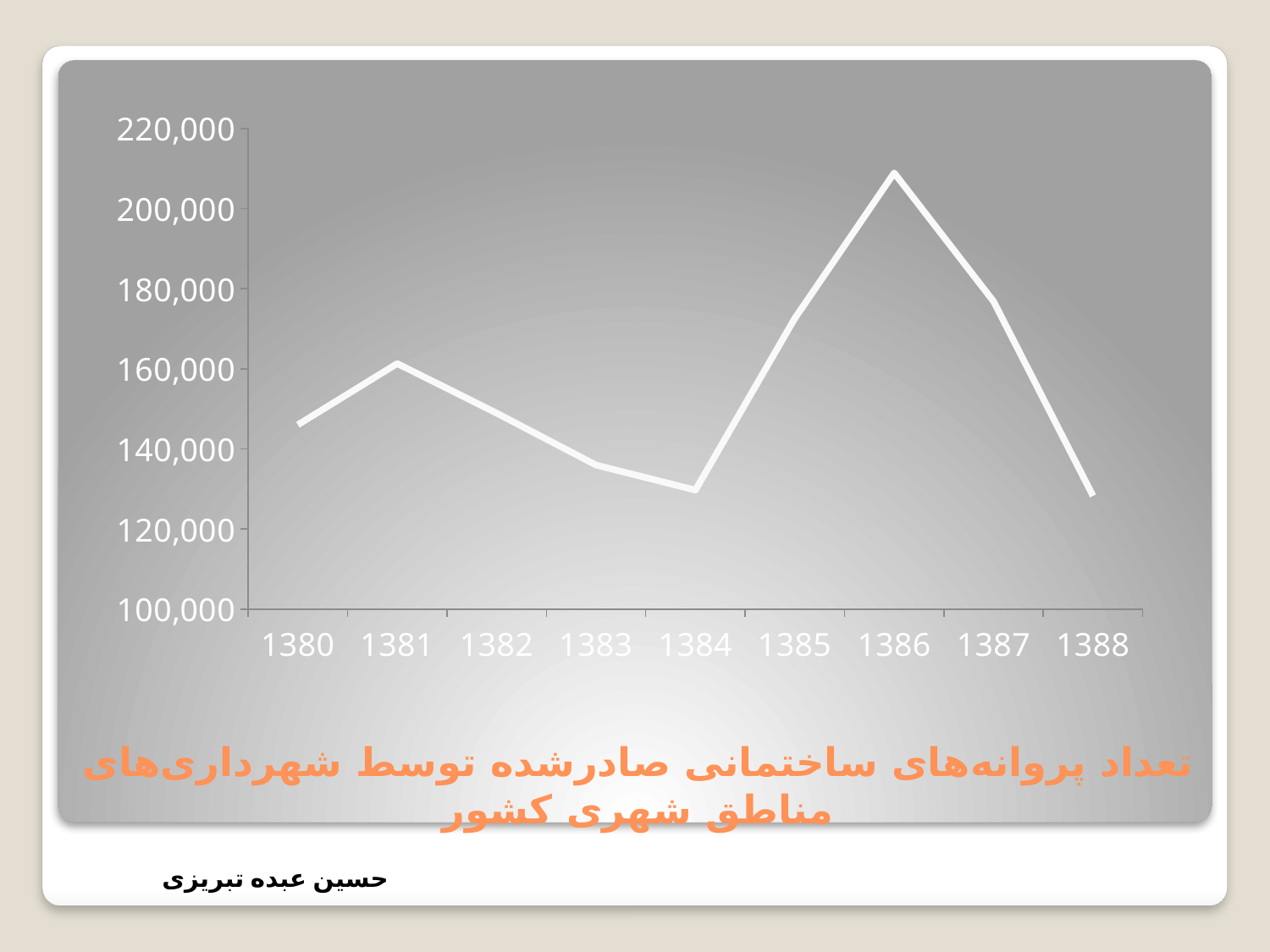
Is the value for 1384 greater or less than 140,000? less Which is larger, the value for 1381 or the value for 1386? 1386 Which year has the highest value on the chart? 1386 Which is larger, the value for 1380 or the value for 1384? 1380 How many years are plotted along the x axis? 9 Do the values rise or fall from 1384 to 1386? rise Is the value for 1388 greater or less than 140,000? less What kind of chart is shown on the slide? line chart Do the values rise or fall from 1386 to 1388? fall Is the value for 1385 greater or less than 160,000? greater